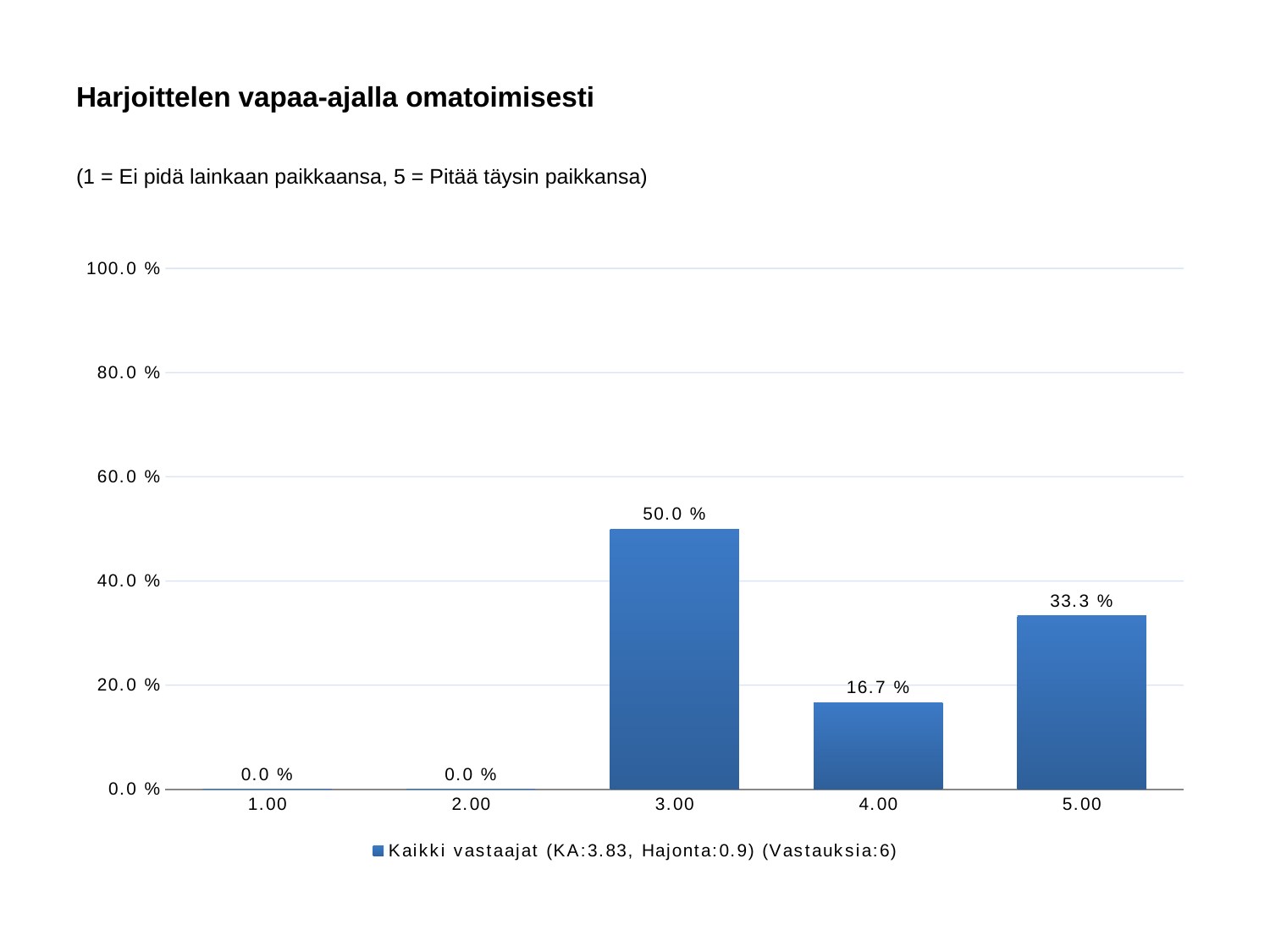
What is the difference between the values for 3.00 and 5.00? 16.7 % Which is larger, the value for 4.00 or the value for 5.00? 5.00 Which category has the highest value? 3.00 What is the difference between the values for 5.00 and 4.00? 16.6 % What is the value for category 5.00? 33.3 % What is the value for category 1.00? 0.0 % What kind of chart is shown on the slide? bar chart What is the value for category 3.00? 50.0 % Is the value for 3.00 greater or less than 40.0 %? greater How many categories are shown on the x axis? 5 What is the title of the chart? Harjoittelen vapaa-ajalla omatoimisesti What is the value for category 4.00? 16.7 %